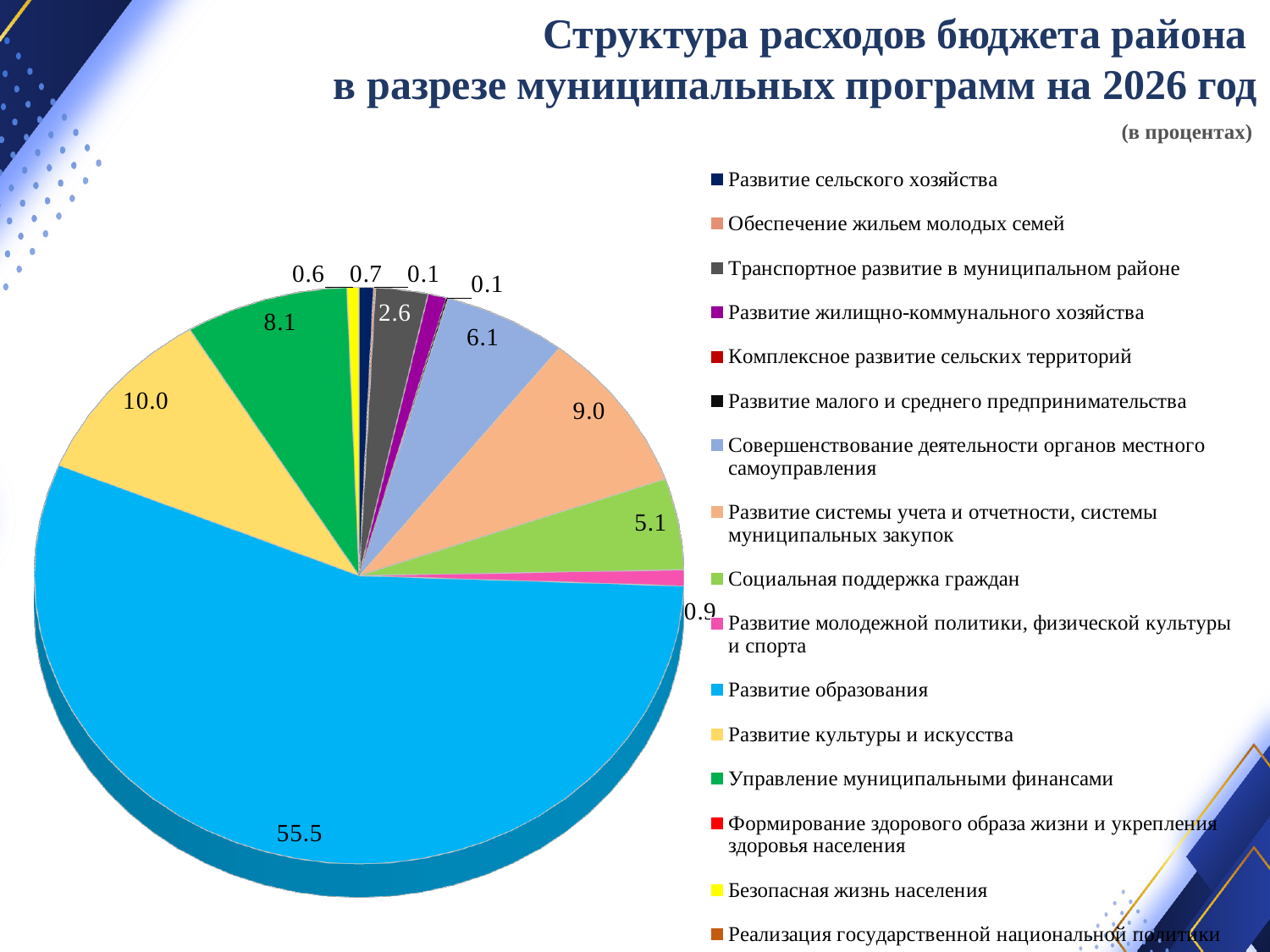
What share of the budget expenditure goes to Развитие образования? 55.5 In what units are the values on the chart expressed, according to the note under the title? в процентах What value is shown for Развитие культуры и искусства? 10.0 How many entries does the legend list? 16 What value is shown for Социальная поддержка граждан? 5.1 Which is larger: the share for Социальная поддержка граждан or for Совершенствование деятельности органов местного самоуправления? Совершенствование деятельности органов местного самоуправления What is the difference between the values for Развитие культуры и искусства and Управление муниципальными финансами? 1.9 Which municipal program has the largest share of the budget expenditure? Развитие образования What value is shown for Совершенствование деятельности органов местного самоуправления? 6.1 What kind of chart is shown on the slide? pie chart What value is shown for Развитие системы учета и отчетности, системы муниципальных закупок? 9.0 What value is shown for Управление муниципальными финансами? 8.1